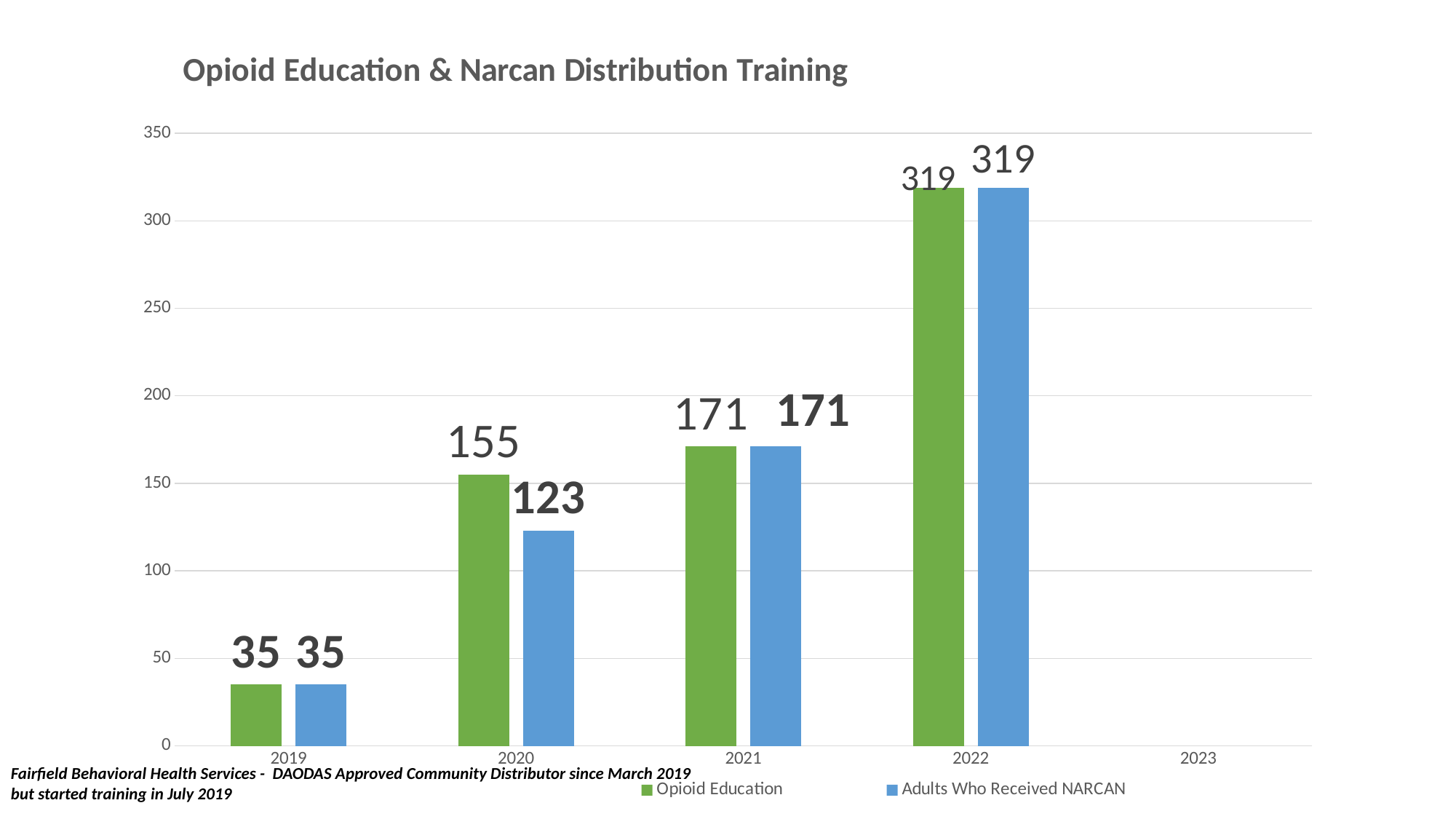
What is the value for Opioid Education in 2022? 319 Which is larger in 2020: Opioid Education or Adults Who Received NARCAN? Opioid Education What is the difference between Opioid Education and Adults Who Received NARCAN in 2020? 32 What is the value for Adults Who Received NARCAN in 2019? 35 Which year has the lowest value for Adults Who Received NARCAN among the years with bars? 2019 What is the value for Adults Who Received NARCAN in 2020? 123 What is the value for Opioid Education in 2020? 155 What kind of chart is shown on the slide? Bar chart Which year has the highest value for Opioid Education? 2022 Do the Opioid Education values rise or fall from 2019 to 2022? Rise What is the title of the chart? Opioid Education & Narcan Distribution Training How many series does the legend list? 2